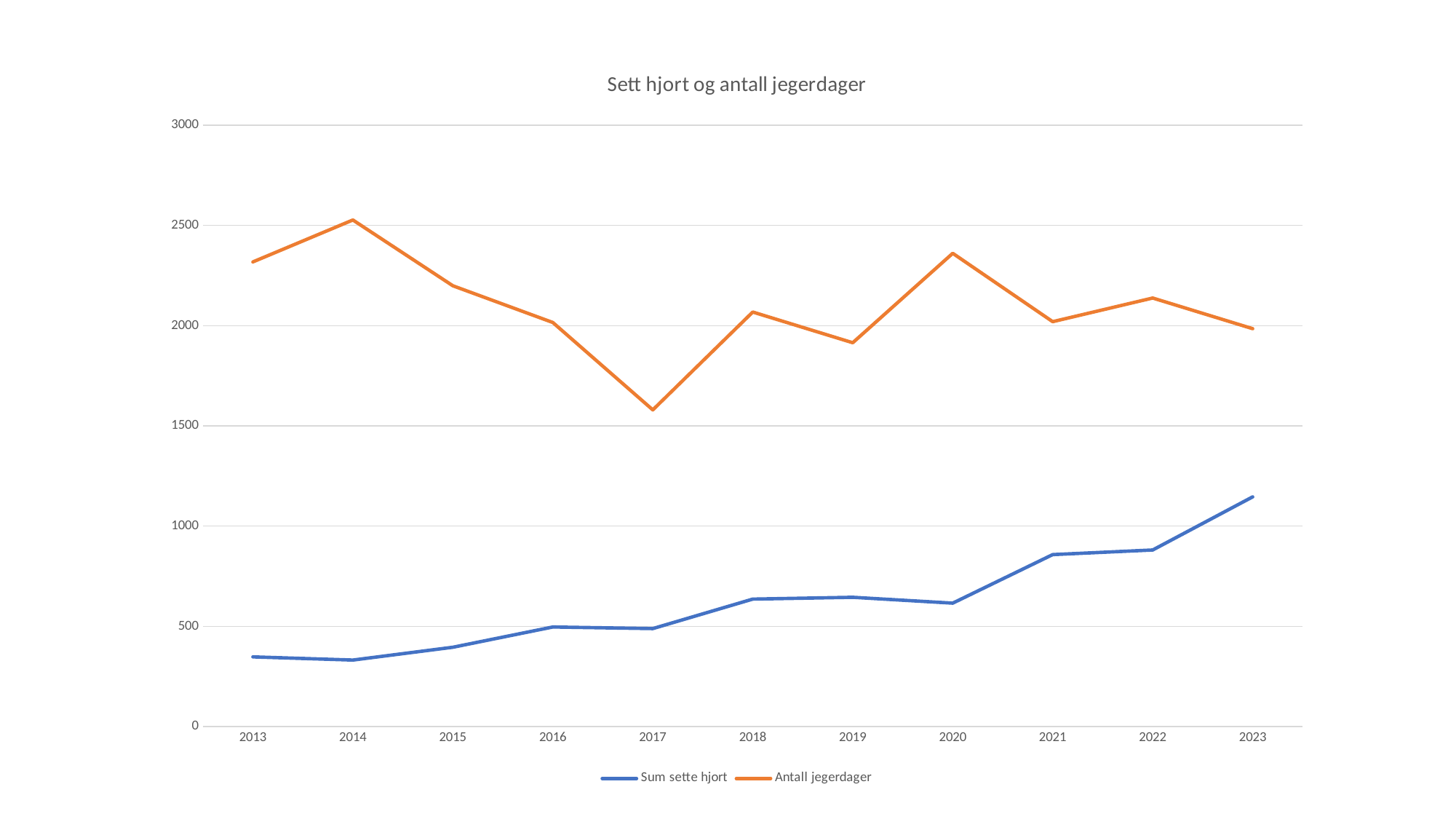
Is the value for Sum sette hjort in 2023 greater or less than 1000? greater Which series is drawn in orange? Antall jegerdager In which year is Antall jegerdager lowest? 2017 Is the value for Antall jegerdager in 2017 greater or less than 2000? less Which is larger for Antall jegerdager: the value in 2020 or the value in 2021? 2020 Does Sum sette hjort generally rise or fall from 2013 to 2023? rise In which year is Antall jegerdager highest? 2014 In which year is Sum sette hjort highest? 2023 What is the title of the chart? Sett hjort og antall jegerdager How many series does the legend list? 2 What kind of chart is shown on the slide? line chart How many years are shown on the x axis? 11